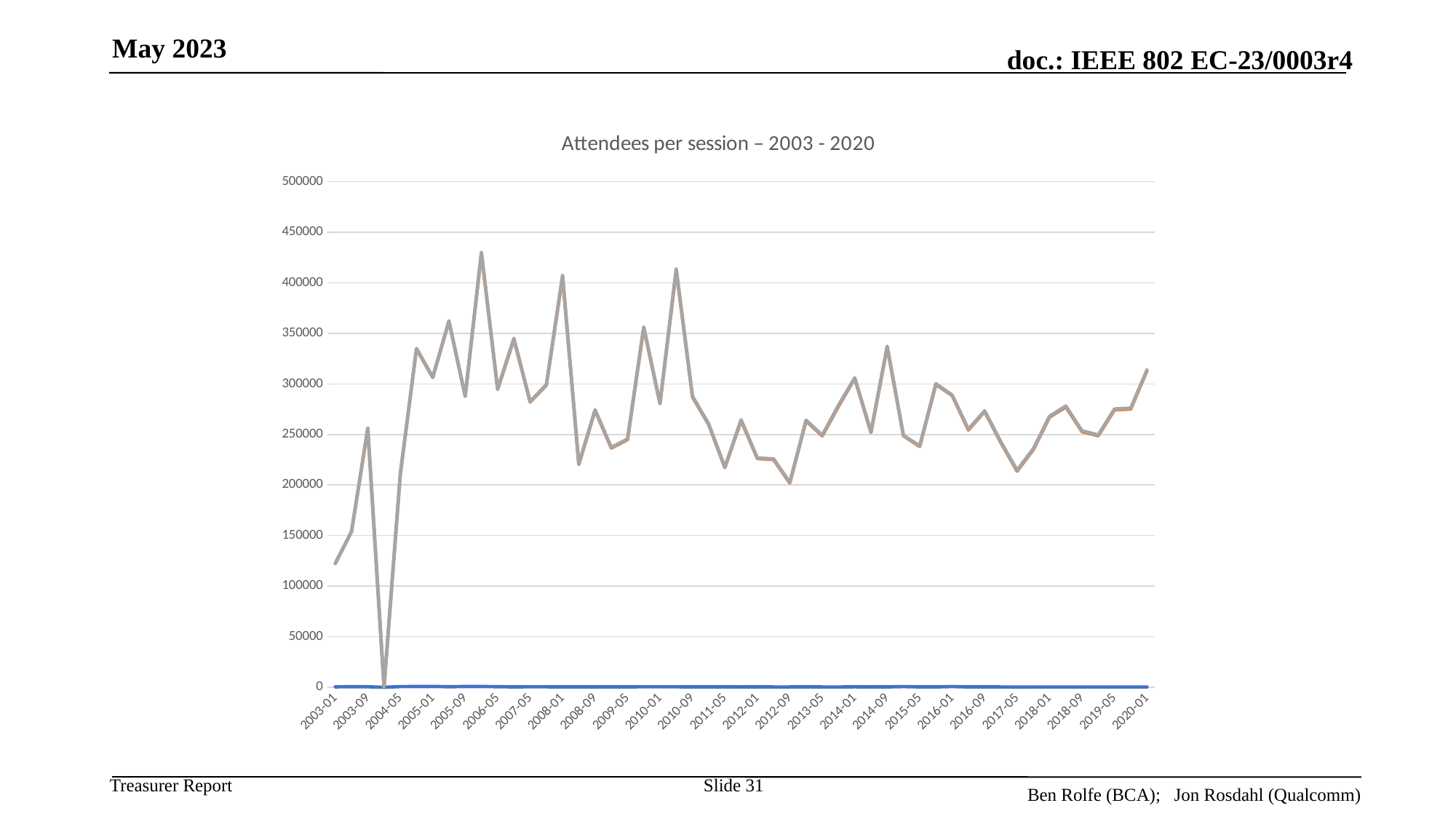
Is the value for 2011-05 greater or less than 250000? less Is the value for 2005-01 greater or less than 300000? greater What is the highest value shown on the vertical axis of the chart? 500000 What is the title of the chart? Attendees per session – 2003 - 2020 Is the value for 2003-01 greater or less than 150000? less What kind of chart is shown on the slide? line chart Which has more attendees, 2008-01 or 2012-09? 2008-01 Do the attendee numbers rise or fall between 2017-05 and 2020-01? rise